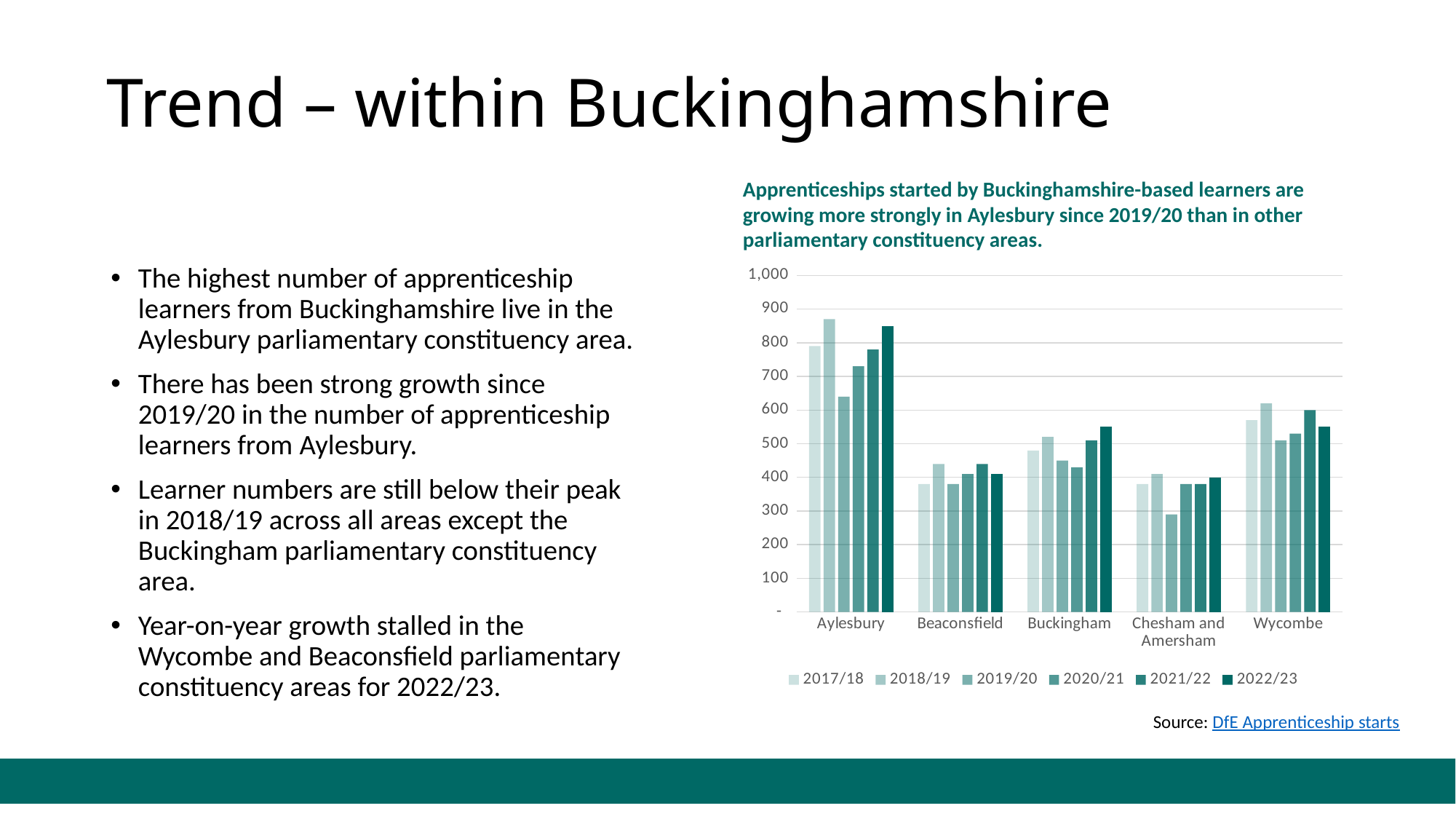
Which is larger, the 2021/22 value for Wycombe or the 2021/22 value for Buckingham? Wycombe Which year is the first entry in the chart legend? 2017/18 Which constituency area has the lowest bar for 2019/20? Chesham and Amersham Which constituency area has the highest bar for 2018/19? Aylesbury Do the values for Aylesbury rise or fall from 2019/20 to 2022/23? rise How many parliamentary constituency areas are shown on the x axis of the chart? 5 Is the value for Buckingham in 2022/23 greater or less than 500? greater Is the value for Aylesbury in 2018/19 greater or less than 800? greater According to the chart title, in which constituency area are apprenticeship starts growing more strongly since 2019/20? Aylesbury How many series (years) does the chart legend list? 6 What kind of chart is shown on the slide? Bar chart